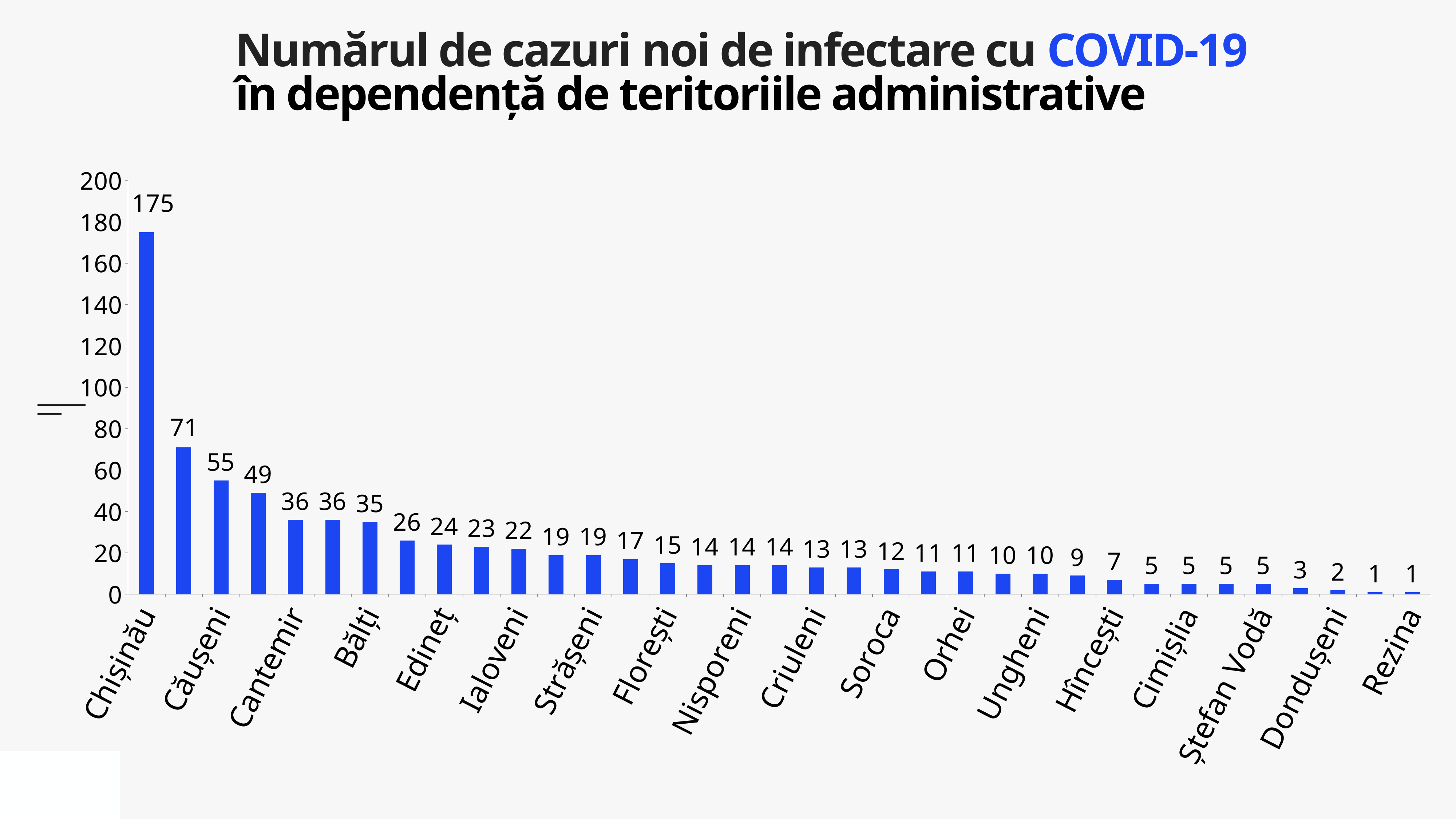
What is the difference between the values for Chișinău and Rezina? 174 Which category has the highest value? Chișinău Do the values rise or fall from left to right along the x axis? fall Which is larger, the value for Chișinău or the value for Rezina? Chișinău What kind of chart is shown on the slide? bar chart What is the highest value shown on the chart? 175 Is the value for Chișinău greater or less than 160? greater What is the value for Chișinău? 175 What colour are the bars in the chart? blue What is the value for Rezina? 1 What is the lowest value shown on the chart? 1 Is the value for Rezina greater or less than 20? less